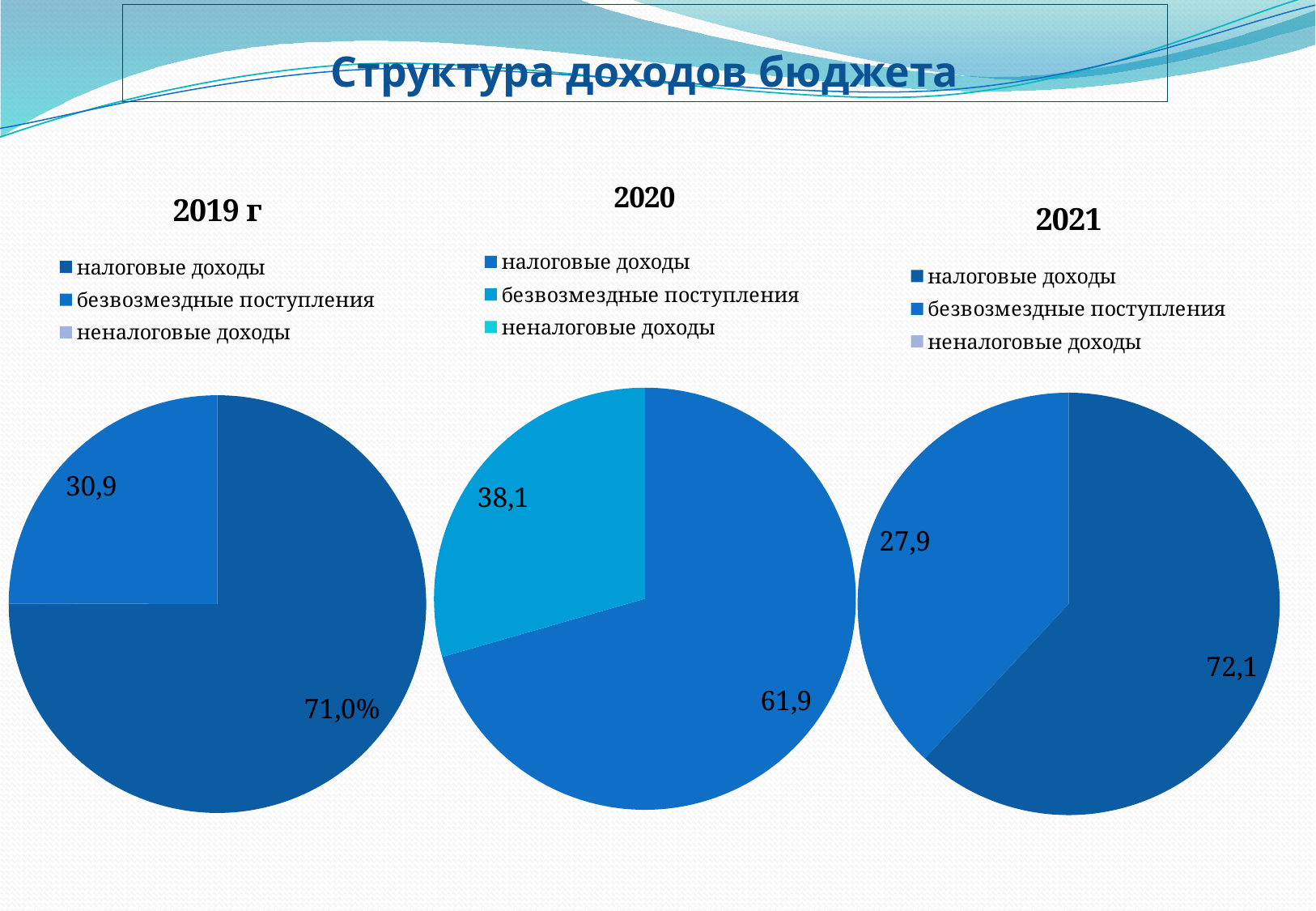
In the 2019 г pie chart, what value is shown for безвозмездные поступления? 30,9 In the 2021 pie chart, what value is shown for безвозмездные поступления? 27,9 In the 2020 pie chart, what is the difference between the налоговые доходы value and the безвозмездные поступления value? 23,8 In the 2020 pie chart, what value is shown for налоговые доходы? 61,9 What is the title of the slide containing the three charts? Структура доходов бюджета In the 2020 pie chart, which category has the largest slice? налоговые доходы What kind of chart is used for 2019 г? pie chart How many entries does the legend of the 2021 chart list? 3 In the 2021 pie chart, what value is shown for налоговые доходы? 72,1 In the 2020 pie chart, what value is shown for безвозмездные поступления? 38,1 In the 2021 pie chart, which is larger: налоговые доходы or безвозмездные поступления? налоговые доходы In the 2019 г pie chart, what value is shown for налоговые доходы? 71,0%